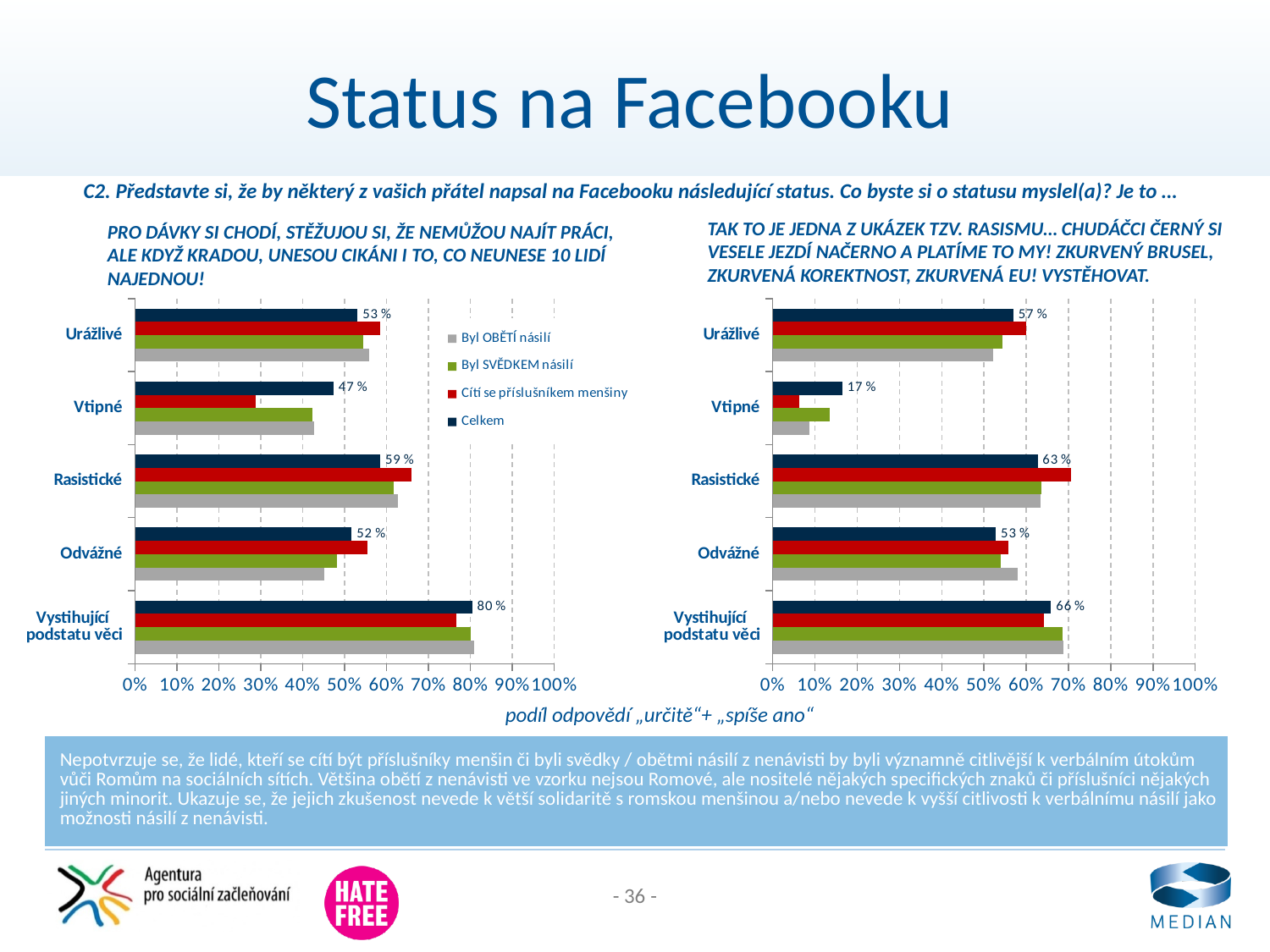
In the left chart, what is the difference between the Celkem values for Vystihující podstatu věci and Vtipné? 33 % Which series is shown in red in the legend? Cítí se příslušníkem menšiny In the right chart, what is the Celkem value for Vtipné? 17 % In the left chart, what is the Celkem value for Vystihující podstatu věci? 80 % In the right chart, which category has the lowest Celkem value? Vtipné Which chart has the higher Celkem value for Rasistické, the left chart or the right chart? the right chart How many categories are shown on the y axis of the left chart? 5 In the right chart, is the Celkem value for Vtipné greater or less than 20%? less What kind of chart is used on this slide? bar chart How many series does the legend list? 4 In the right chart, which category has the highest Celkem value? Vystihující podstatu věci In the left chart, what is the Celkem value for Rasistické? 59 %